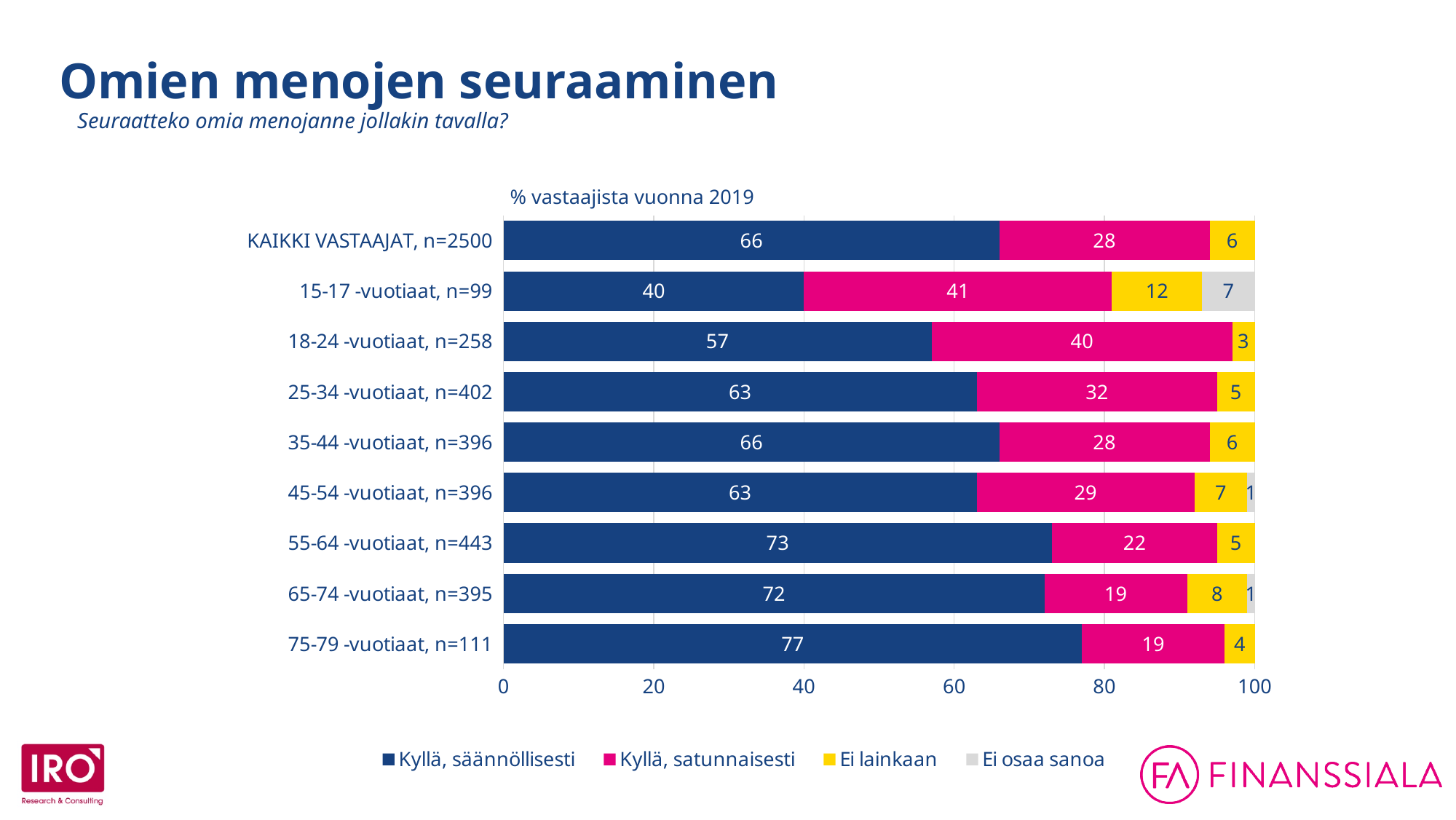
What is the value of "Kyllä, säännöllisesti" for KAIKKI VASTAAJAT, n=2500? 66 What is the total of the stacked bar for 15-17 -vuotiaat, n=99? 100 Which group has the lowest value for "Kyllä, säännöllisesti"? 15-17 -vuotiaat, n=99 How many respondent groups (categories) are plotted on the chart? 9 How many series does the legend list? 4 Which group has the highest value for "Ei lainkaan"? 15-17 -vuotiaat, n=99 What is the difference between the "Kyllä, säännöllisesti" values for 75-79 -vuotiaat and 15-17 -vuotiaat? 37 What is the value of "Ei lainkaan" for 65-74 -vuotiaat, n=395? 8 What kind of chart is shown on the slide? Stacked bar chart Which age group has the highest value for "Kyllä, säännöllisesti"? 75-79 -vuotiaat, n=111 Which has a larger "Kyllä, satunnaisesti" value: 18-24 -vuotiaat, n=258 or 25-34 -vuotiaat, n=402? 18-24 -vuotiaat, n=258 What is the value of "Kyllä, satunnaisesti" for 15-17 -vuotiaat, n=99? 41